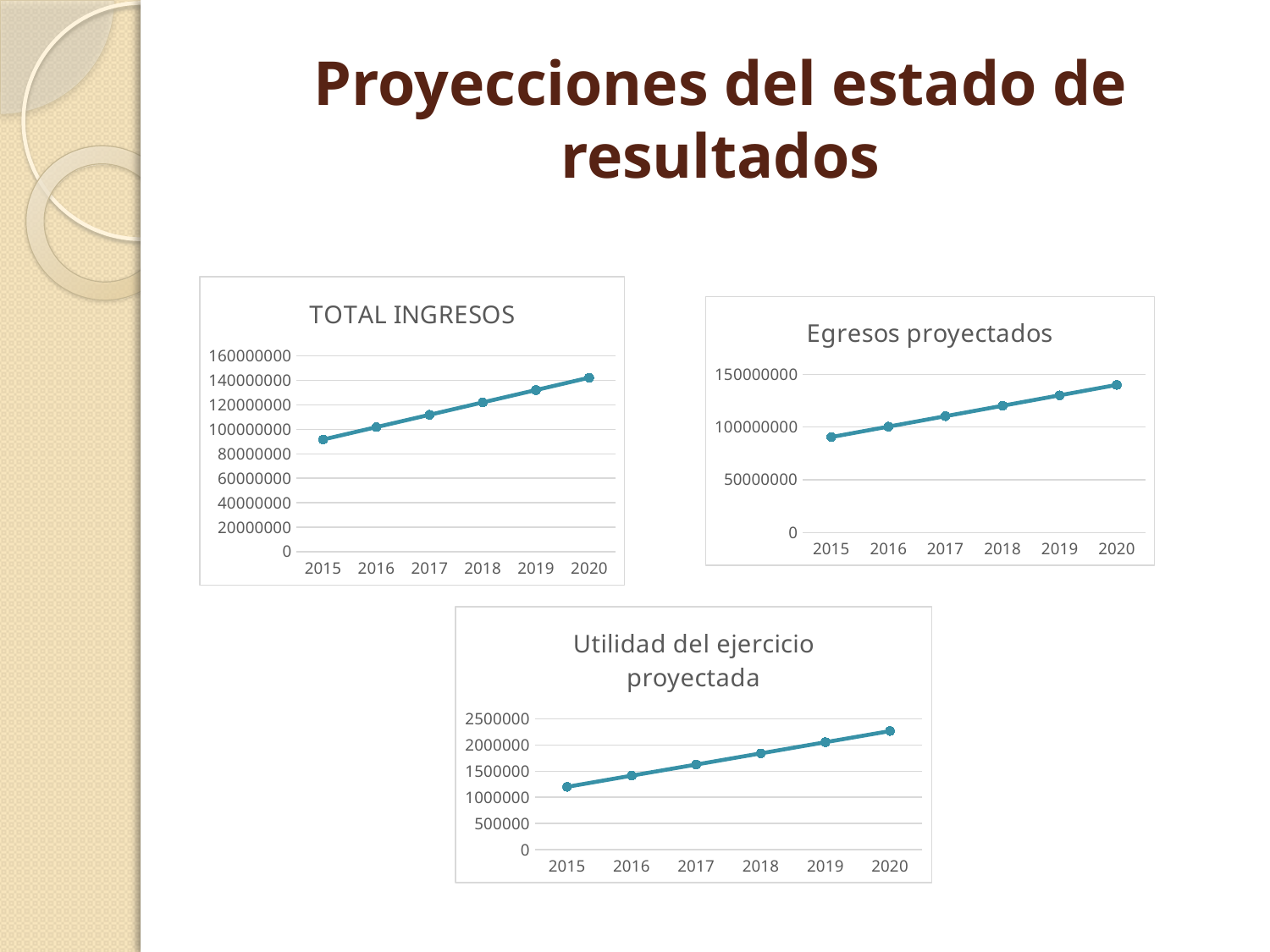
In the "Egresos proyectados" chart, is the value for 2020 greater or less than 150000000? less In the "Egresos proyectados" chart, which year has the lowest value? 2015 In the "TOTAL INGRESOS" chart, is the value for 2015 greater or less than 100000000? less In the "TOTAL INGRESOS" chart, which year has the highest value? 2020 In the "TOTAL INGRESOS" chart, is the value for 2019 greater or less than 120000000? greater How many years are plotted on the "Egresos proyectados" chart? 6 In the "Utilidad del ejercicio proyectada" chart, do the values rise or fall from 2015 to 2020? rise What is the title of the chart at the bottom of the slide? Utilidad del ejercicio proyectada In the "Utilidad del ejercicio proyectada" chart, which is larger, the value for 2016 or the value for 2019? 2019 What kind of chart is the "TOTAL INGRESOS" chart? line chart